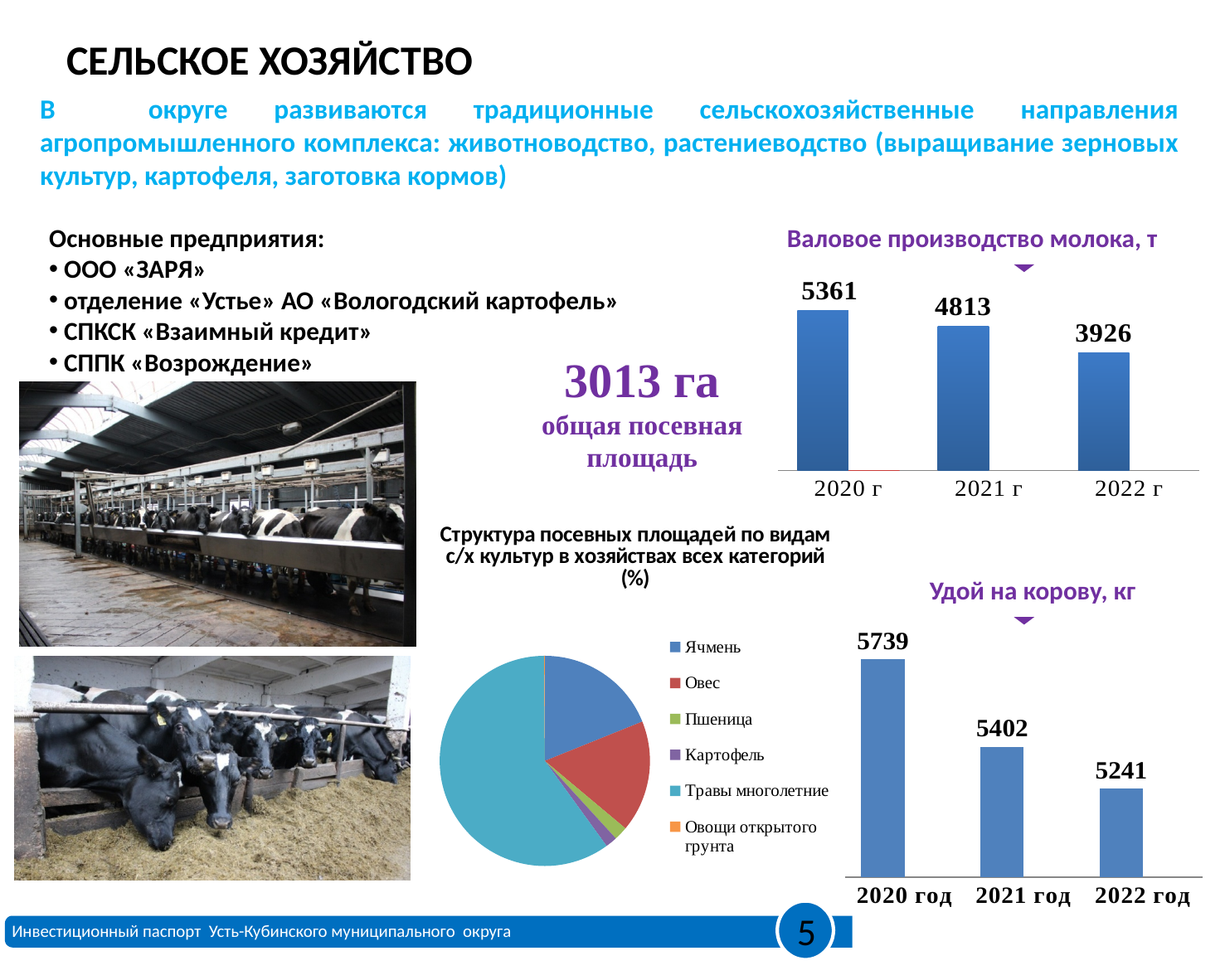
In the chart 'Валовое производство молока, т', which year has the highest value? 2020 г How many entries does the legend of the pie chart 'Структура посевных площадей по видам с/х культур' list? 6 In the chart 'Удой на корову, кг', what is the difference between the 2020 год and 2021 год values? 337 In the chart 'Валовое производство молока, т', do the values rise or fall from 2020 г to 2022 г? fall In the chart 'Валовое производство молока, т', what is the difference between the 2020 г and 2022 г values? 1435 In the chart 'Валовое производство молока, т', what is the value for 2020 г? 5361 In the chart 'Удой на корову, кг', how many bars are plotted? 3 In the chart 'Валовое производство молока, т', what is the value for 2022 г? 3926 In the pie chart 'Структура посевных площадей по видам с/х культур', which category has the largest slice? Травы многолетние In the chart 'Удой на корову, кг', which year has the lowest value? 2022 год What kind of chart is 'Структура посевных площадей по видам с/х культур в хозяйствах всех категорий (%)'? pie chart In the chart 'Удой на корову, кг', what is the value for 2021 год? 5402